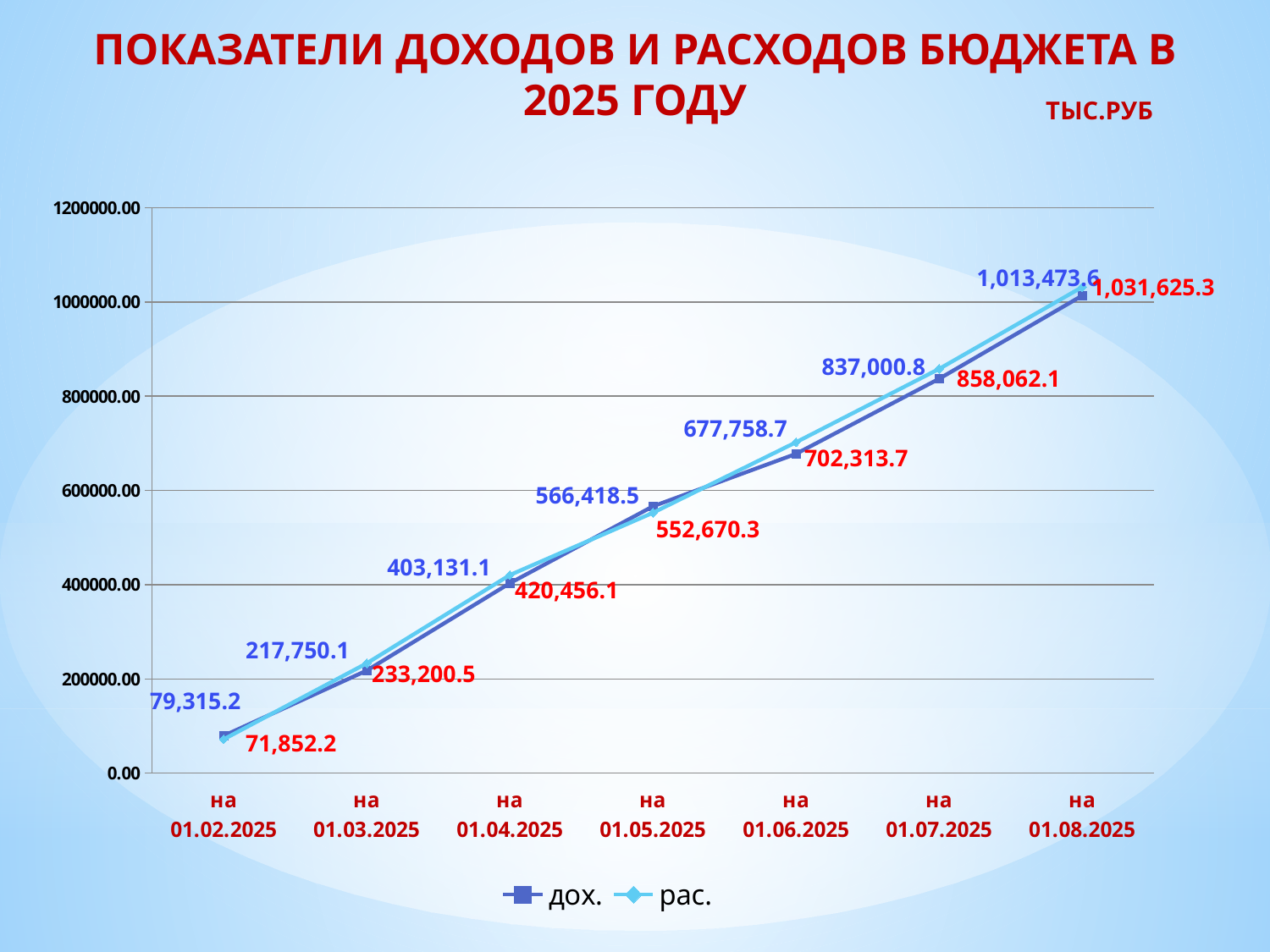
What is the value of дох. on 01.05.2025? 566,418.5 Do the values of дох. rise or fall from 01.02.2025 to 01.08.2025? rise On which date is the value of дох. highest? на 01.08.2025 On which date is the value of рас. lowest? на 01.02.2025 What is the value of рас. on 01.06.2025? 702,313.7 What type of chart is shown on the slide? line chart How many dates are plotted along the x axis? 7 What is the difference between рас. and дох. on 01.08.2025? 18,151.7 How many series does the legend list? 2 What is the value of дох. on 01.02.2025? 79,315.2 What is the value of рас. on 01.08.2025? 1,031,625.3 Which is larger on 01.07.2025, дох. or рас.? рас.